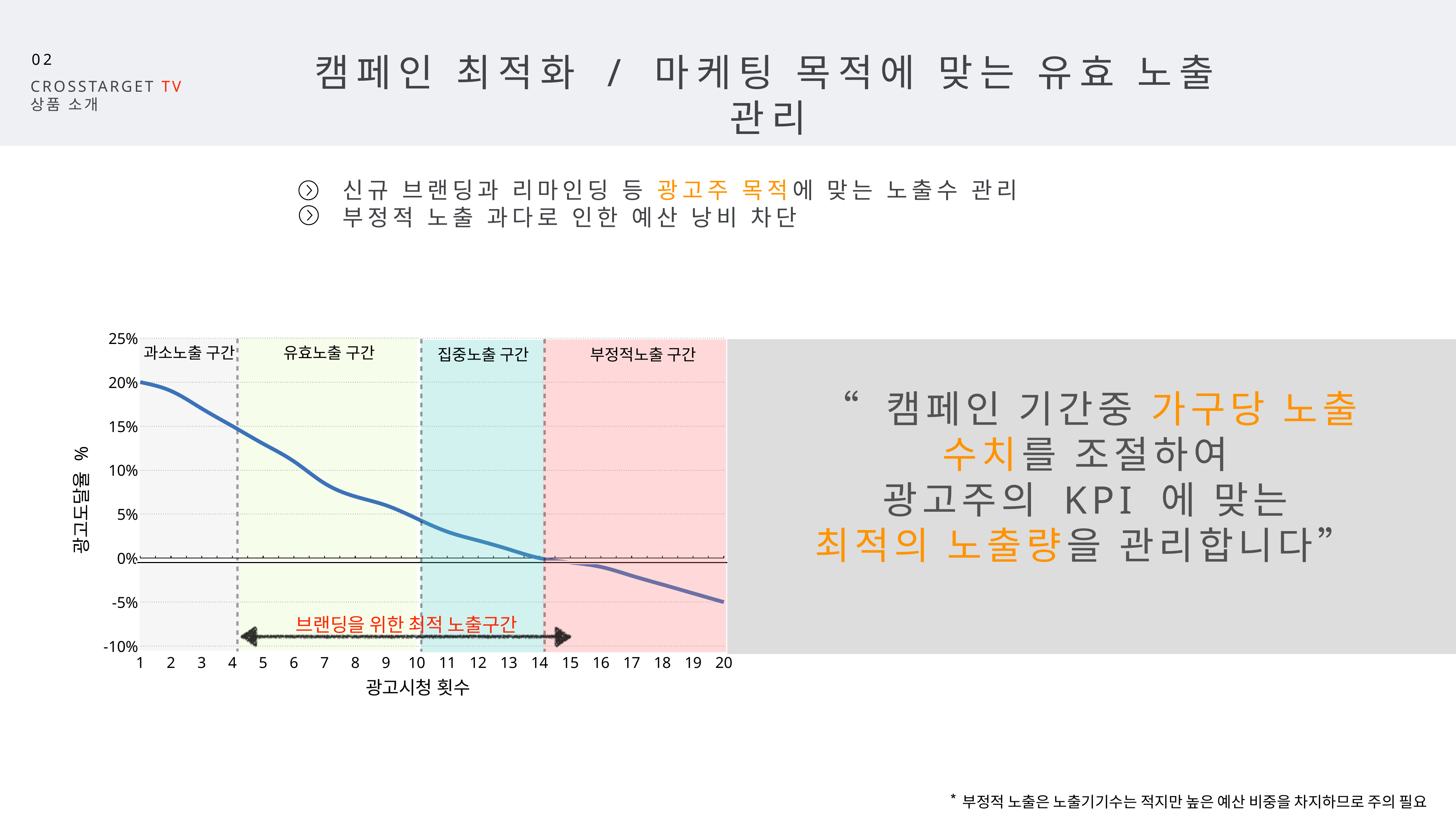
What is the 광고도달율 at 광고시청 횟수 1? 20% How many 광고시청 횟수 values are shown along the x axis of the chart? 20 Does 광고도달율 rise or fall as 광고시청 횟수 increases along the x axis? fall Is the 광고도달율 at 광고시청 횟수 8 greater or less than 10%? less At which 광고시청 횟수 is 광고도달율 lowest? 20 Is the 광고도달율 at 광고시청 횟수 4 greater or less than 10%? greater Which has a higher 광고도달율: 광고시청 횟수 5 or 광고시청 횟수 15? 5 What is the title of the x axis of the chart? 광고시청 횟수 At which 광고시청 횟수 is 광고도달율 highest? 1 Is the 광고도달율 at 광고시청 횟수 17 greater or less than 0%? less How many shaded 구간 (zones) are labelled across the top of the chart? 4 What kind of chart is shown on the slide? line chart